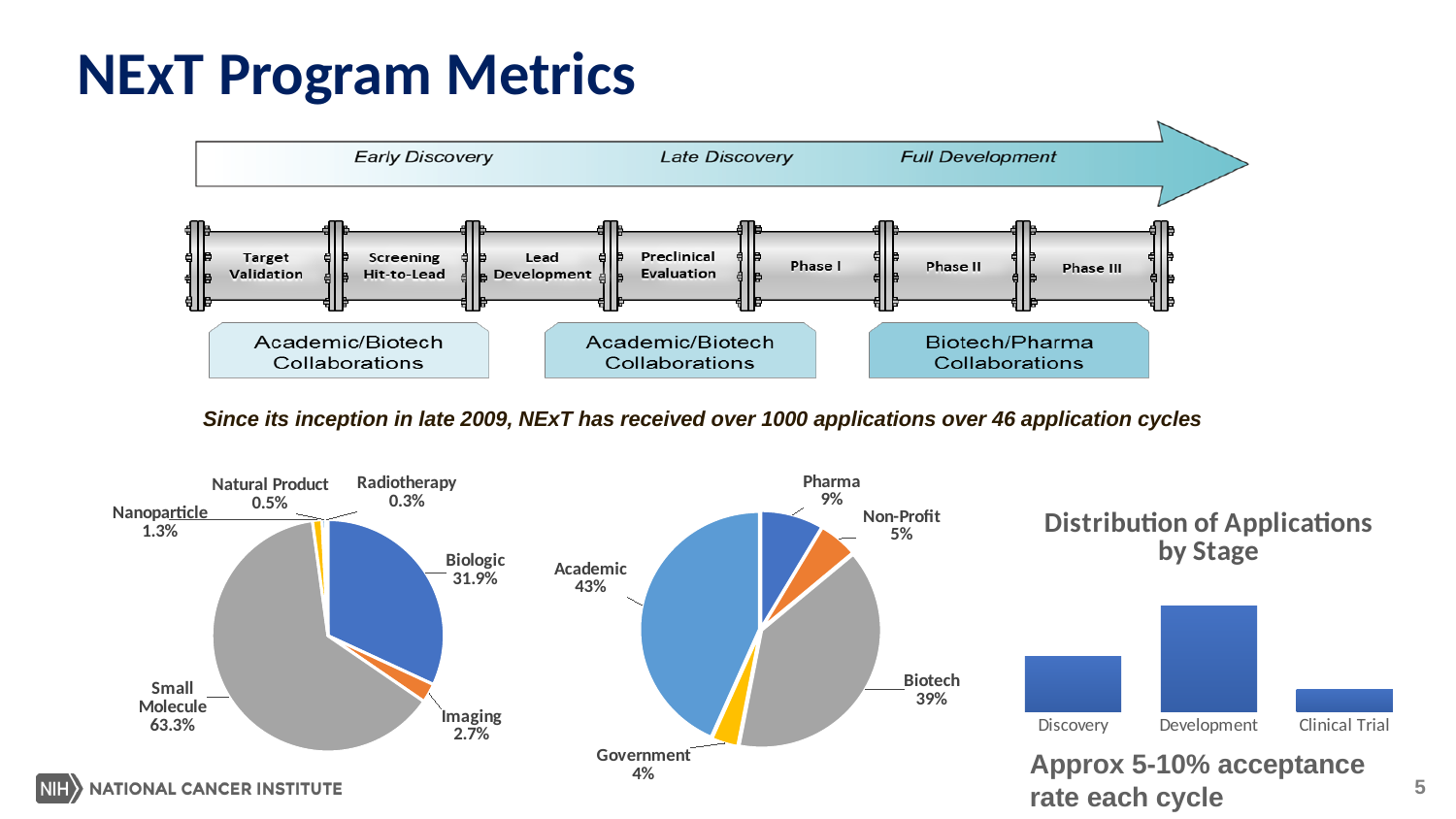
In the left pie chart, what share is Biologic? 31.9% In the left pie chart, what share is Small Molecule? 63.3% In the middle pie chart, what share is Government? 4% In the middle pie chart, which category has the largest share? Academic In the chart titled 'Distribution of Applications by Stage', which stage has the highest bar? Development In the left pie chart, what is the difference between the Small Molecule and Biologic shares? 31.4% In the middle pie chart, which is larger, Pharma or Non-Profit? Pharma In the left pie chart, which category has the smallest share? Radiotherapy In the middle pie chart, what share is Academic? 43% What kind of chart is 'Distribution of Applications by Stage'? Bar chart In the middle pie chart, what is the difference between the Biotech and Pharma shares? 30% In the left pie chart, how many categories are shown? 6